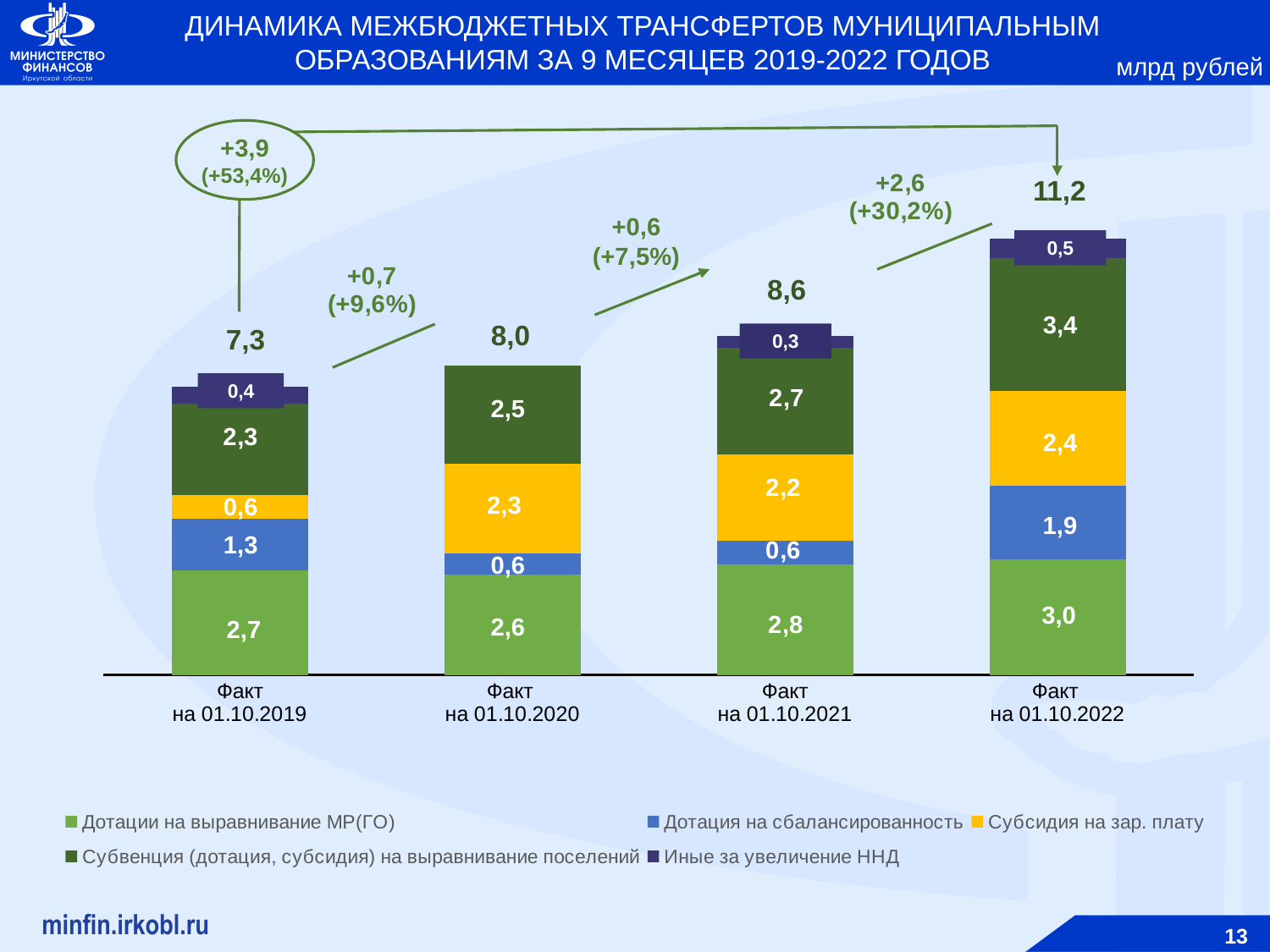
Do the total values rise or fall from Факт на 01.10.2019 to Факт на 01.10.2022? rise Which category has the lowest total value? Факт на 01.10.2019 What is the value of Дотация на сбалансированность for Факт на 01.10.2022? 1,9 What type of chart is shown on the slide? stacked bar chart How many bars (categories) are shown on the x axis? 4 What is the total value of the bar for Факт на 01.10.2022? 11,2 Which is larger: Субвенция (дотация, субсидия) на выравнивание поселений for Факт на 01.10.2020 or for Факт на 01.10.2022? Факт на 01.10.2022 How many series does the legend list? 5 What is the difference between the total for Факт на 01.10.2022 and the total for Факт на 01.10.2021? 2,6 What is the value of Субсидия на зар. плату for Факт на 01.10.2019? 0,6 Which category has the highest total value? Факт на 01.10.2022 What is the value of Дотации на выравнивание МР(ГО) for Факт на 01.10.2021? 2,8